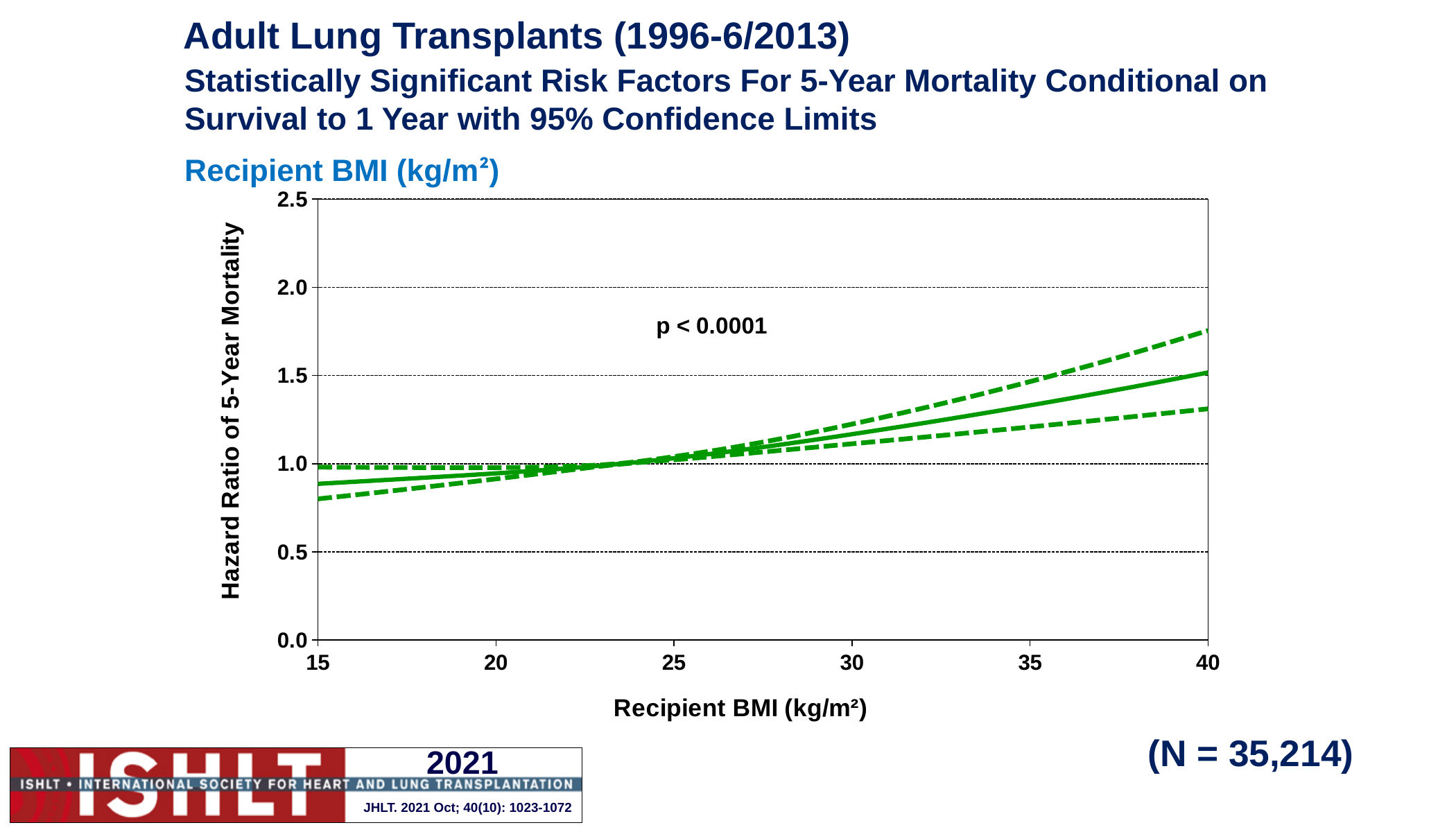
Is the hazard ratio (solid line) at a recipient BMI of 40 greater or less than 2.0? less What is the label of the y axis? Hazard Ratio of 5-Year Mortality Does the hazard ratio of 5-year mortality rise or fall as recipient BMI increases from 15 to 40? rise What p-value is printed on the chart? p < 0.0001 How many lines are plotted on the chart? 3 Is the upper 95% confidence limit (upper dashed line) at a recipient BMI of 40 greater or less than 2.0? less Is the hazard ratio (solid line) at a recipient BMI of 15 greater or less than 1.0? less What kind of chart is shown on the slide? line chart Which has the larger hazard ratio on the solid line: a recipient BMI of 15 or a recipient BMI of 40? 40 At which recipient BMI value on the x axis does the solid hazard ratio line reach its highest point? 40